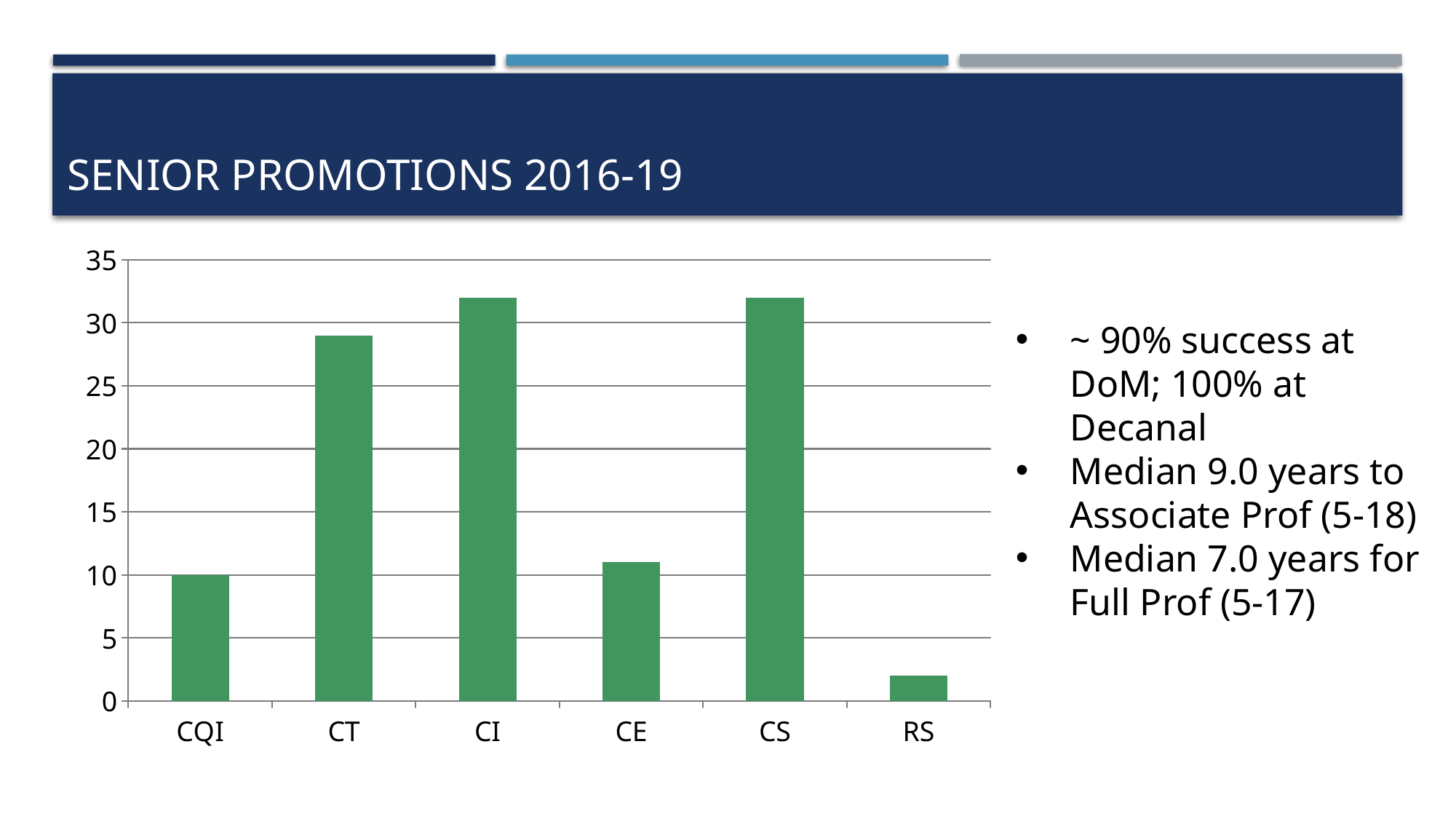
Is the value for CI greater or less than 30? greater Is the value for RS greater or less than 5? less Is the value for CE greater or less than 15? less Which category has the lowest value in the chart? RS What is the title of the slide containing the chart? SENIOR PROMOTIONS 2016-19 What is the value for CQI in the chart? 10 Which is larger, the value for CT or the value for CE? CT How many categories are shown on the x axis of the chart? 6 Which is larger, the value for CQI or the value for RS? CQI What type of chart is shown on the slide? bar chart